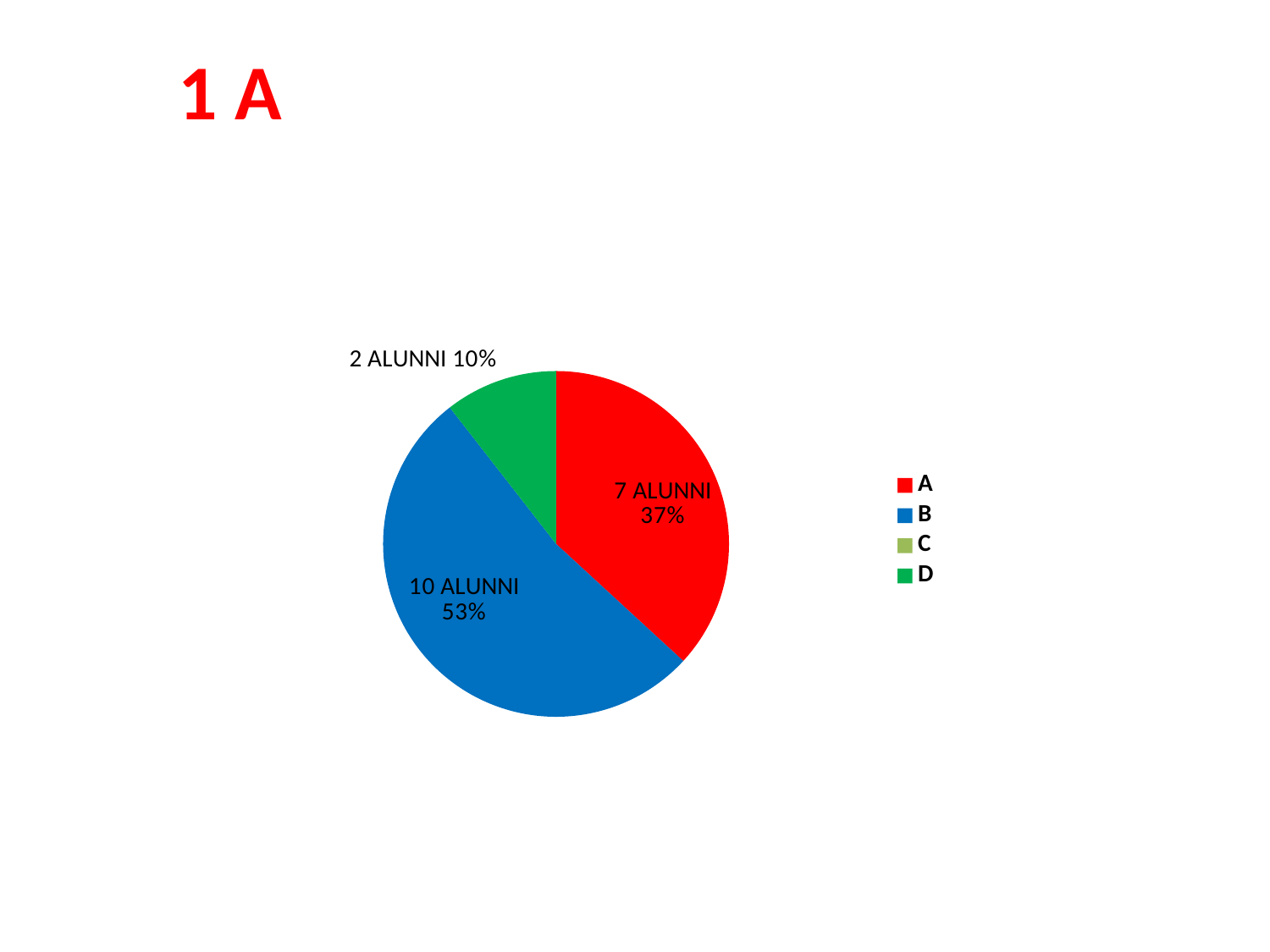
What percentage of the pie does category A represent? 37% Which category with a visible slice has the smallest share of the pie? D What percentage of the pie does category B represent? 53% What percentage of the pie does category D represent? 10% Which category has the largest slice of the pie? B How many entries does the legend list? 4 What kind of chart is shown on the slide? pie chart How many alunni are in category A? 7 ALUNNI How many more alunni are in category B than in category A? 3 How many alunni are in category D? 2 ALUNNI How many alunni are in category B? 10 ALUNNI Which is larger, the slice for A or the slice for D? A